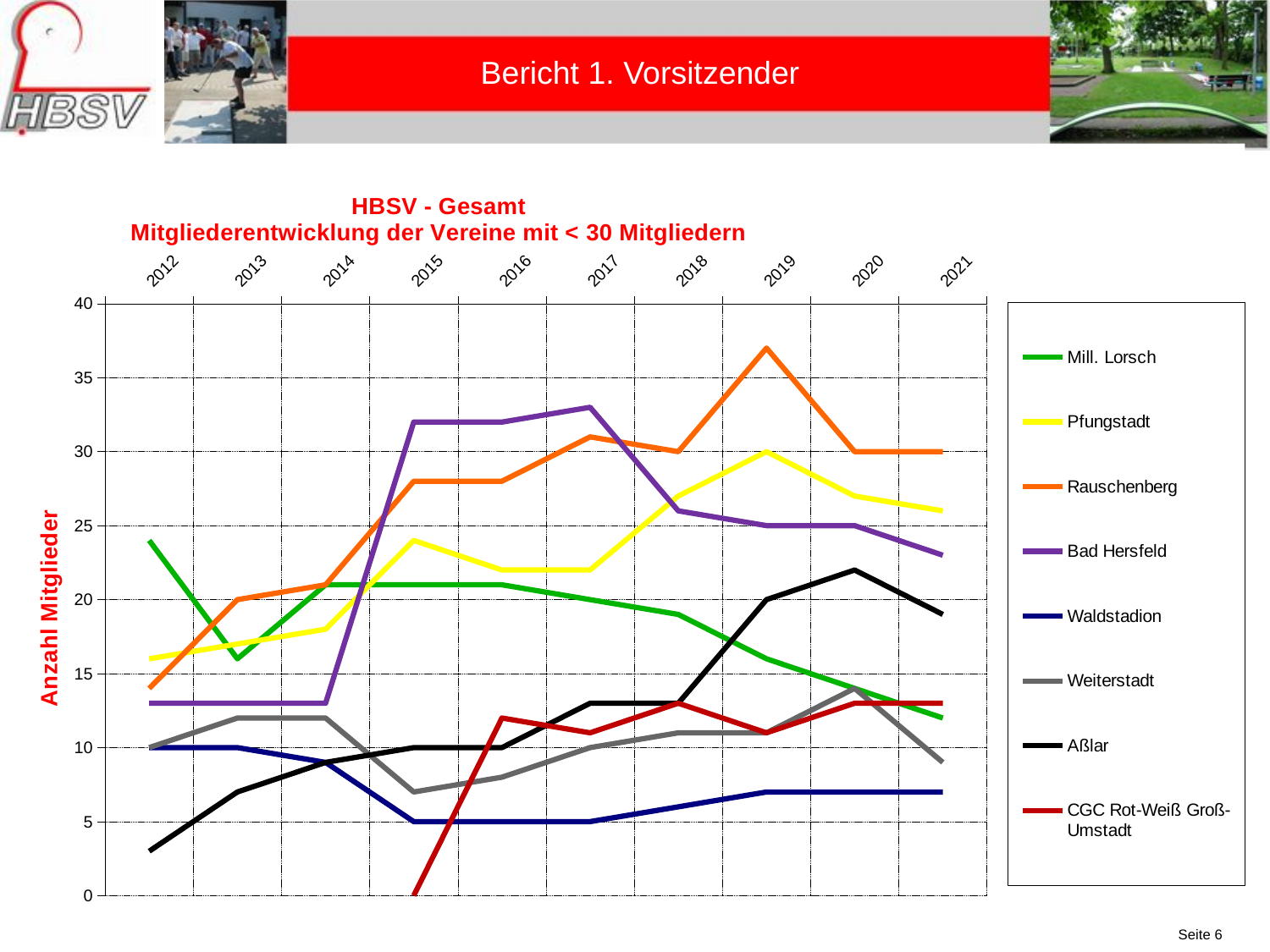
Is the value for Rauschenberg in 2019 greater or less than 35? greater What is the value for Waldstadion in 2015? 5 What is the label of the y axis? Anzahl Mitglieder Is the value for Bad Hersfeld in 2015 greater or less than 30? greater How many series does the legend list? 8 Is the value for Aßlar in 2012 greater or less than 5? less Does the value for Bad Hersfeld rise or fall from 2017 to 2021? fall What kind of chart is shown on the slide? line chart Which series has the lowest value in 2012? Aßlar How many years are plotted along the x axis? 10 In 2021, which is larger, the value for Rauschenberg or the value for Pfungstadt? Rauschenberg Which series has the highest value in 2019? Rauschenberg